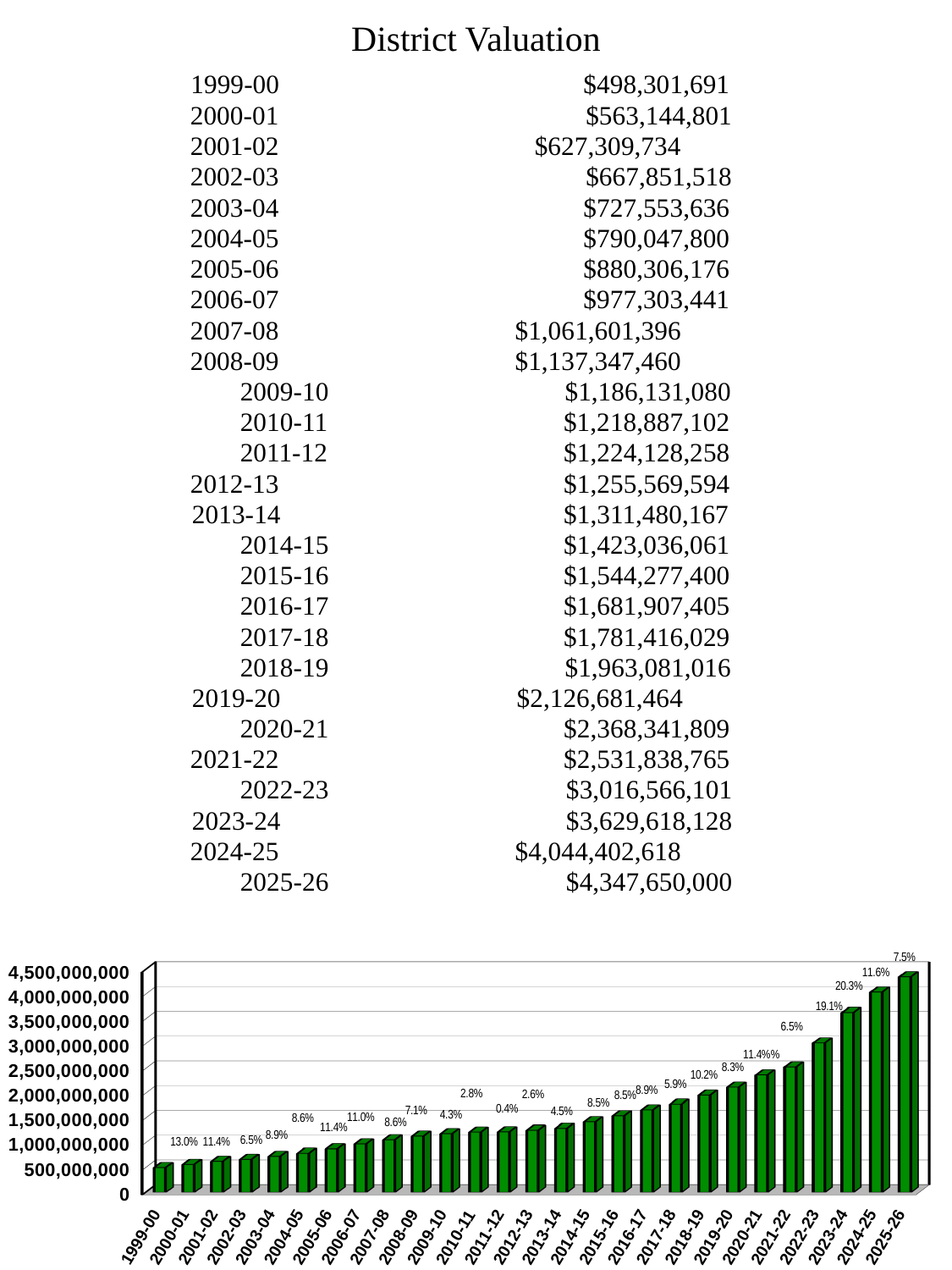
Which is larger, the district valuation for 2019-20 or for 2018-19? 2019-20 Which fiscal year has the lowest district valuation? 1999-00 What is the district valuation for 2025-26? $4,347,650,000 What kind of chart is shown on the slide? bar chart How many fiscal years are plotted on the x axis of the chart? 27 Which fiscal year has the highest district valuation? 2025-26 What is the difference between the district valuation for 2025-26 and 2024-25? $303,247,382 Do the district valuation values rise or fall from 1999-00 to 2025-26? rise What is the title of the chart on the slide? District Valuation Is the bar for 2025-26 greater or less than 4,000,000,000? greater What is the district valuation for 2012-13? $1,255,569,594